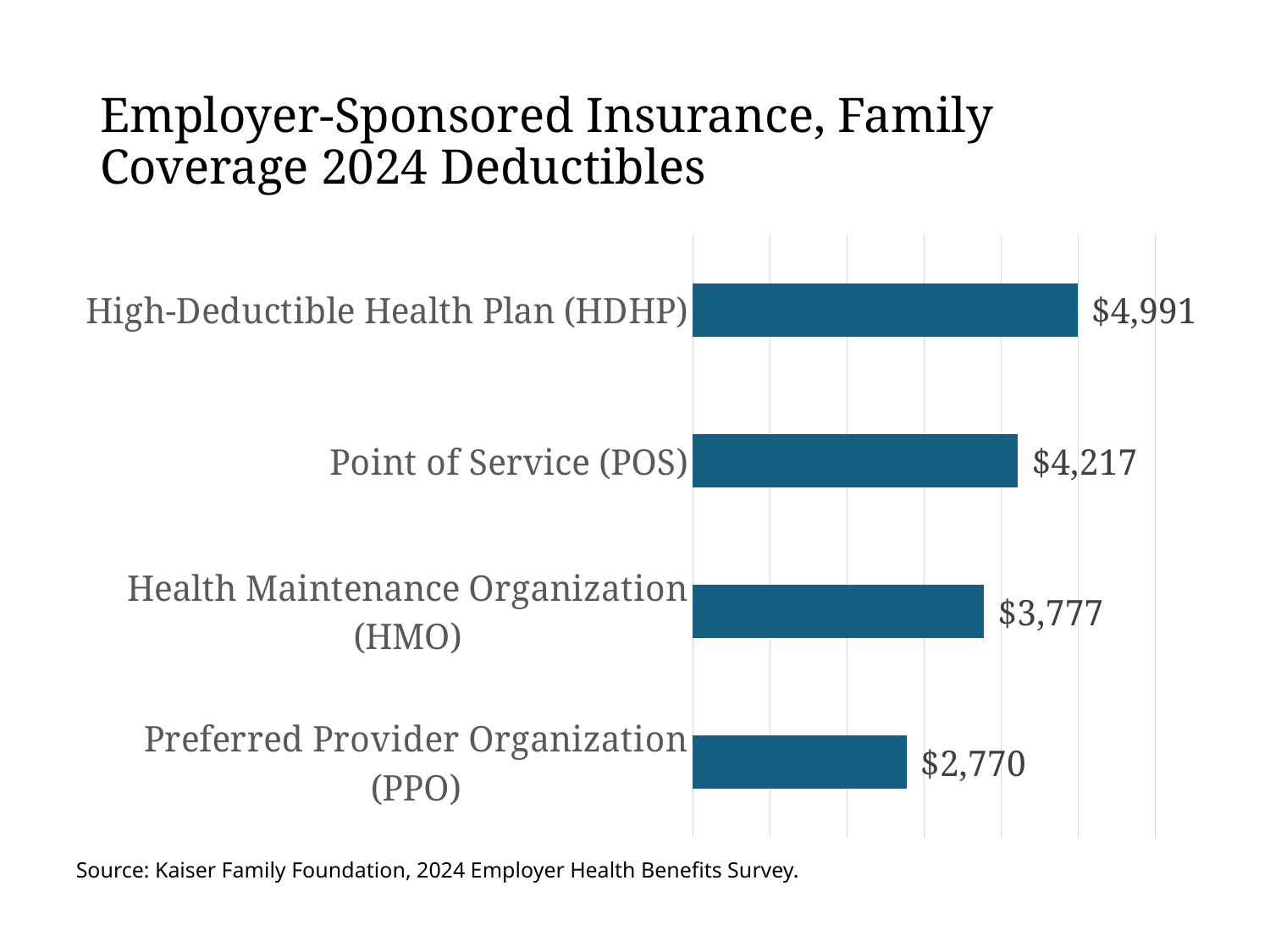
Which plan type has the lowest family coverage deductible? Preferred Provider Organization (PPO) What is the difference between the POS and HMO deductibles? $440 Which plan type has the highest family coverage deductible? High-Deductible Health Plan (HDHP) How many plan types are shown in the chart? 4 What kind of chart is shown on the slide? Bar chart How much higher is the HDHP deductible than the PPO deductible? $2,221 What is the deductible shown for Preferred Provider Organization (PPO)? $2,770 What is the title of the chart? Employer-Sponsored Insurance, Family Coverage 2024 Deductibles What is the 2024 family coverage deductible for the High-Deductible Health Plan (HDHP)? $4,991 What is the deductible shown for Point of Service (POS)? $4,217 What is the deductible shown for Health Maintenance Organization (HMO)? $3,777 Which has a larger deductible, POS or HMO? Point of Service (POS)